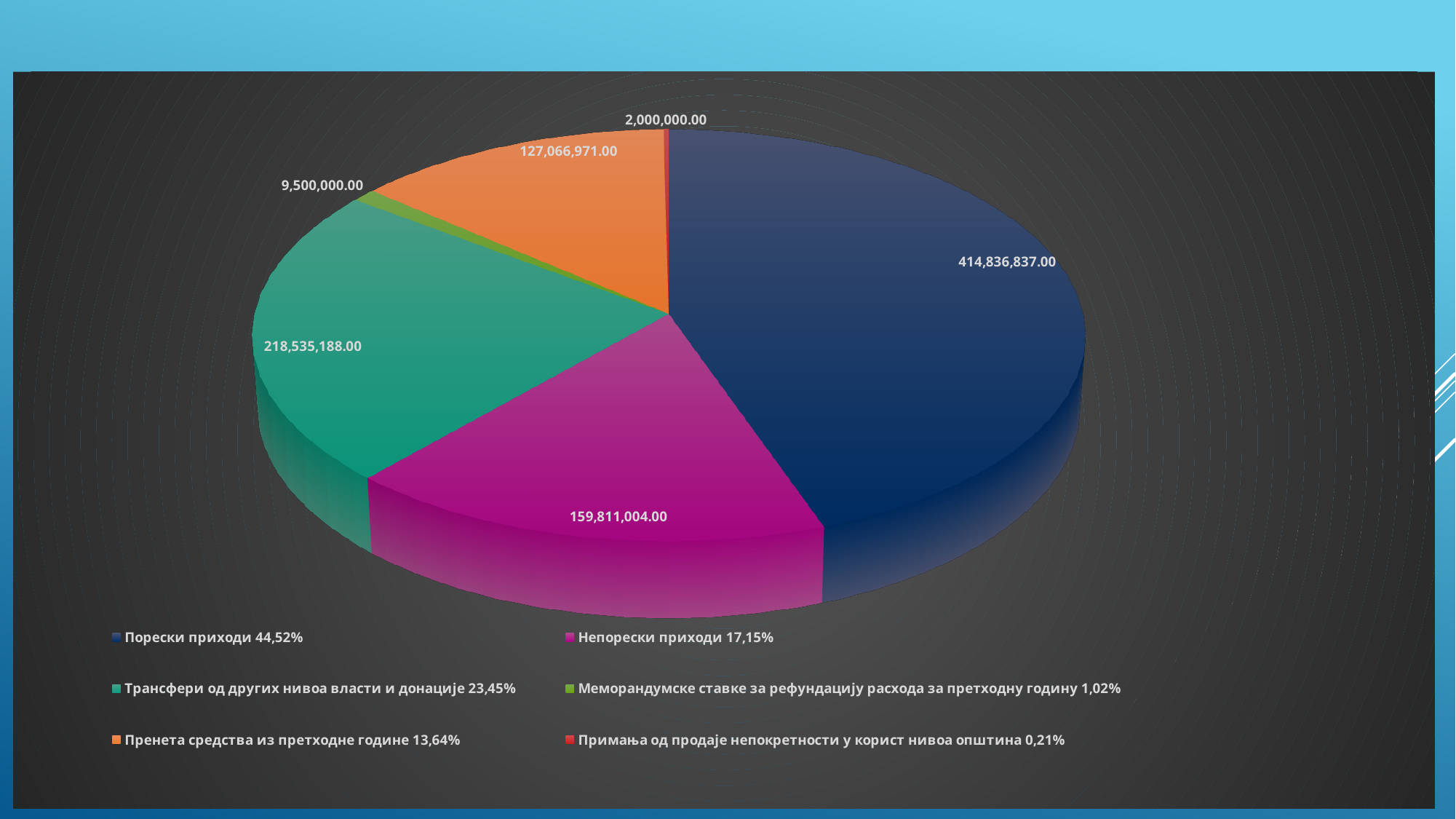
What is the value for Пренета средства из претходне године? 127,066,971.00 How many slices does the pie chart have? 6 What colour is the slice for Меморандумске ставке за рефундацију расхода за претходну годину? green Which is larger, the value for Непорески приходи or the value for Пренета средства из претходне године? Непорески приходи What is the difference between the values for Порески приходи and Трансфери од других нивоа власти и донације? 196,301,649.00 What type of chart is shown on the slide? pie chart What is the value for Трансфери од других нивоа власти и донације? 218,535,188.00 What is the value for Примања од продаје непокретности у корист нивоа општина? 2,000,000.00 Which category has the largest slice of the pie? Порески приходи What share of the pie does Непорески приходи represent, according to the legend? 17,15% What is the value for Порески приходи? 414,836,837.00 Which category has the smallest slice of the pie? Примања од продаје непокретности у корист нивоа општина